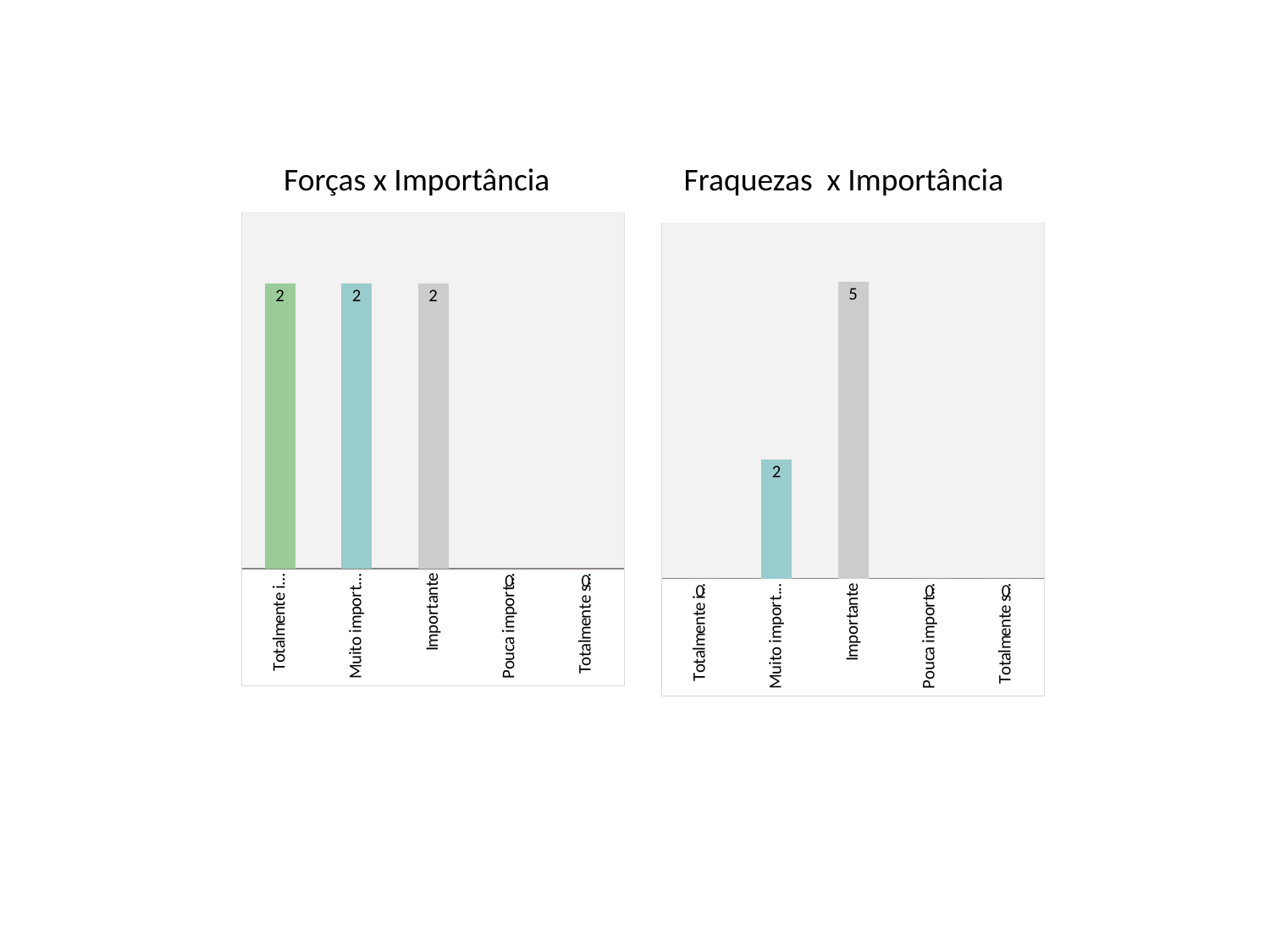
In the 'Forças x Importância' chart, what colour is the first bar (Totalmente i...)? Green How many categories are shown on the x axis of the 'Forças x Importância' chart? 5 Is the value for Importante larger in the 'Forças x Importância' chart or in the 'Fraquezas x Importância' chart? Fraquezas x Importância What is the title of the chart on the left of the slide? Forças x Importância In the 'Fraquezas x Importância' chart, what is the difference between the value for Importante and the value for the second category (Muito import...)? 3 In the 'Fraquezas x Importância' chart, what is the value of the second bar from the left (Muito import...)? 2 What kind of chart is 'Fraquezas x Importância'? Bar chart How many bars with a visible value are shown in the 'Fraquezas x Importância' chart? 2 In the 'Fraquezas x Importância' chart, what is the value for Importante? 5 How many bars with a visible value are shown in the 'Forças x Importância' chart? 3 In the 'Forças x Importância' chart, what is the value for Importante? 2 In the 'Fraquezas x Importância' chart, which category has the highest value? Importante